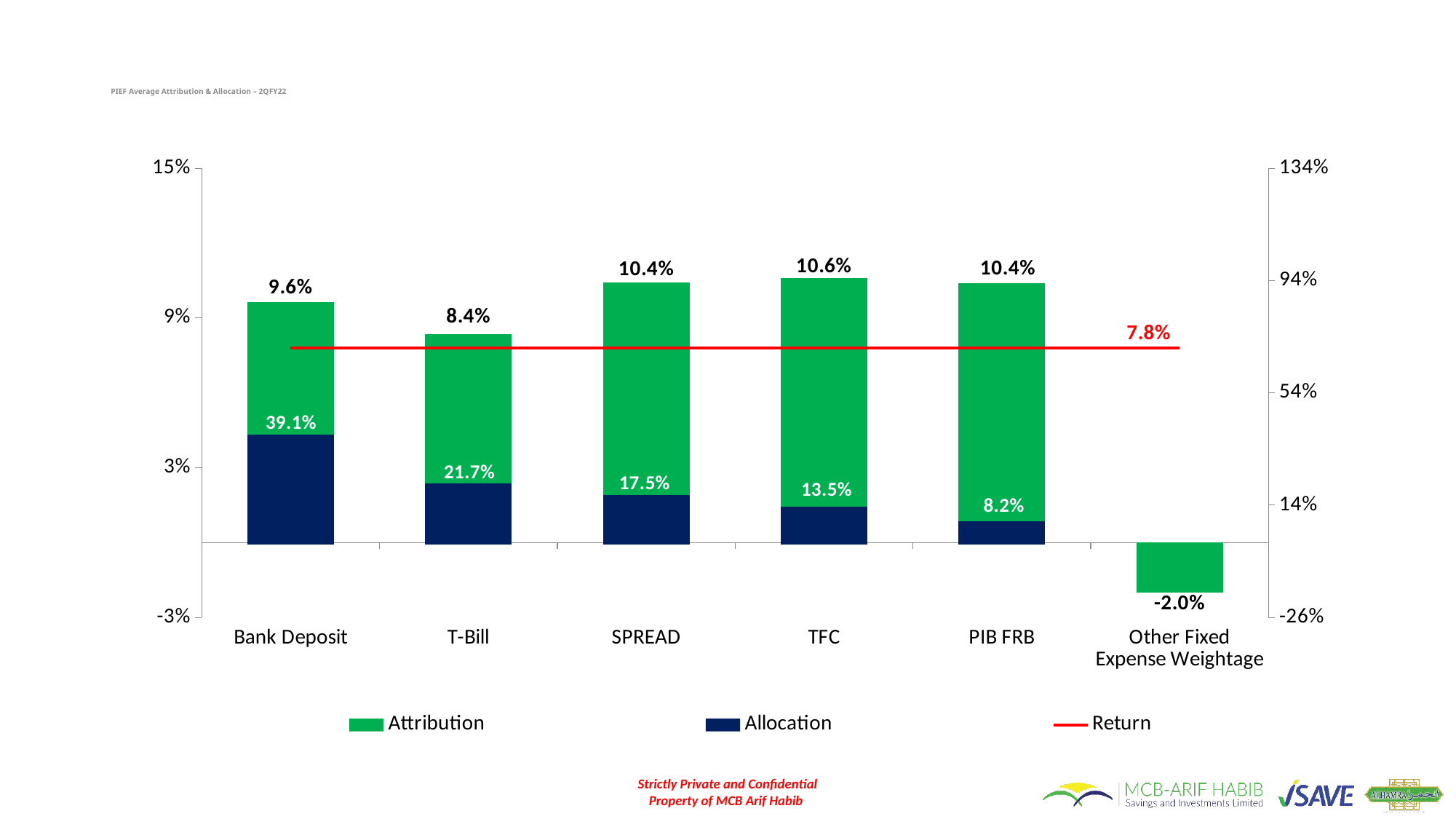
Which is larger, the Attribution value for Bank Deposit or for T-Bill? Bank Deposit How many series does the legend list? 3 What is the Attribution value for TFC? 10.6% What is the Attribution value for Other Fixed Expense Weightage? -2.0% Which category has the highest Attribution value? TFC What is the Allocation value for Bank Deposit? 39.1% Which category has the lowest Allocation value among those labelled? PIB FRB What colour represents the Allocation series? Dark blue How many categories are shown on the x axis? 6 What is the difference between the Allocation values for Bank Deposit and T-Bill? 17.4% What value is labelled on the Return line? 7.8% What kind of chart is this? Bar chart with a line